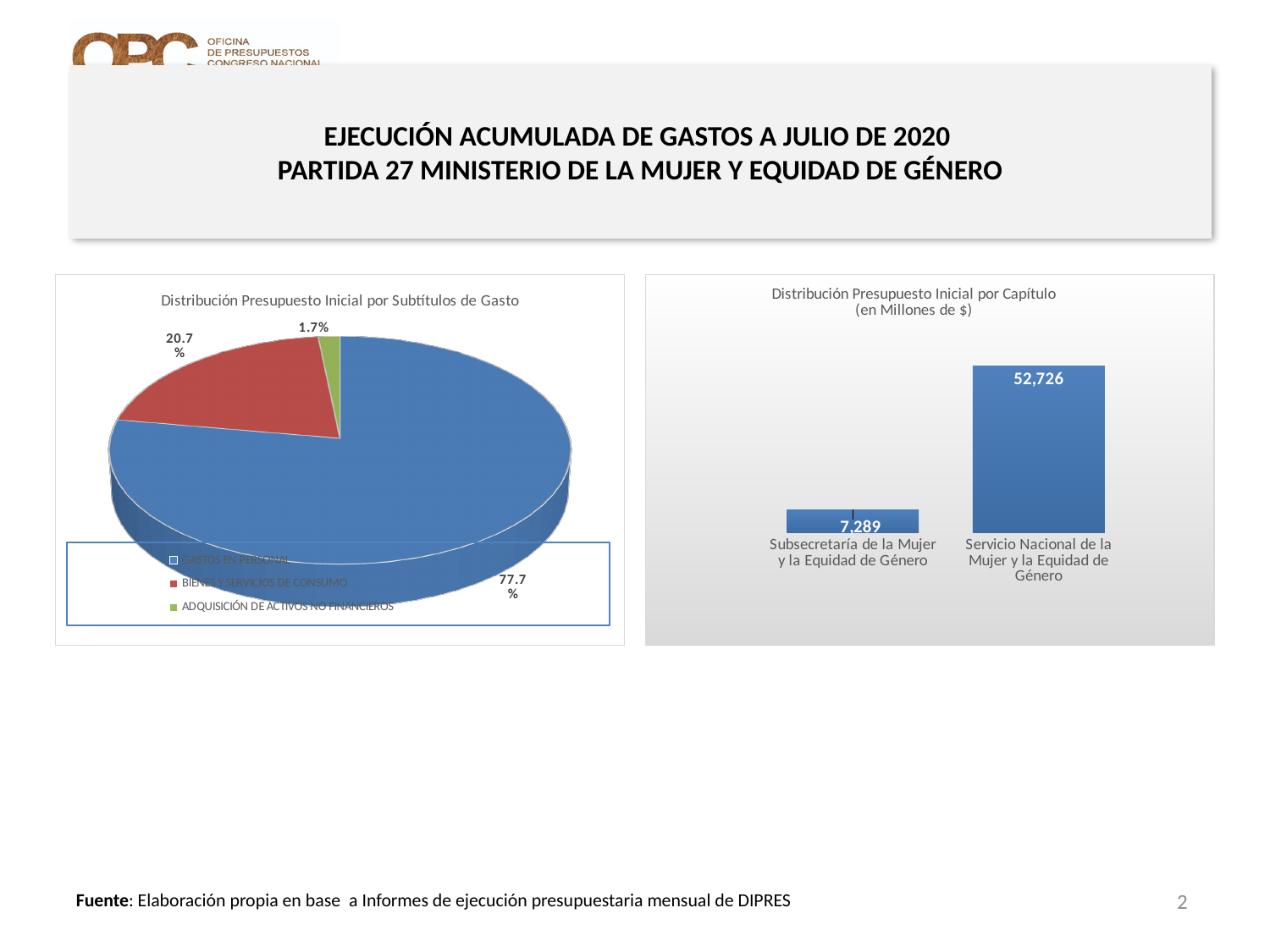
What kind of chart is 'Distribución Presupuesto Inicial por Subtítulos de Gasto'? Pie chart What kind of chart is 'Distribución Presupuesto Inicial por Capítulo'? Bar chart In the chart 'Distribución Presupuesto Inicial por Subtítulos de Gasto', which category has the smallest slice? ADQUISICIÓN DE ACTIVOS NO FINANCIEROS In the chart 'Distribución Presupuesto Inicial por Subtítulos de Gasto', what share does BIENES Y SERVICIOS DE CONSUMO have? 20.7% In the chart 'Distribución Presupuesto Inicial por Subtítulos de Gasto', how many entries does the legend list? 3 In the chart 'Distribución Presupuesto Inicial por Subtítulos de Gasto', what share does ADQUISICIÓN DE ACTIVOS NO FINANCIEROS have? 1.7% In the chart 'Distribución Presupuesto Inicial por Capítulo', what is the difference between the values for Servicio Nacional de la Mujer y la Equidad de Género and Subsecretaría de la Mujer y la Equidad de Género? 45,437 In the chart 'Distribución Presupuesto Inicial por Capítulo', what is the value for Servicio Nacional de la Mujer y la Equidad de Género? 52,726 In the chart 'Distribución Presupuesto Inicial por Capítulo', how many categories are plotted? 2 In the chart 'Distribución Presupuesto Inicial por Capítulo', what is the value for Subsecretaría de la Mujer y la Equidad de Género? 7,289 In the chart 'Distribución Presupuesto Inicial por Capítulo', which category has the highest value? Servicio Nacional de la Mujer y la Equidad de Género In the chart 'Distribución Presupuesto Inicial por Subtítulos de Gasto', what share does GASTOS EN PERSONAL have? 77.7%